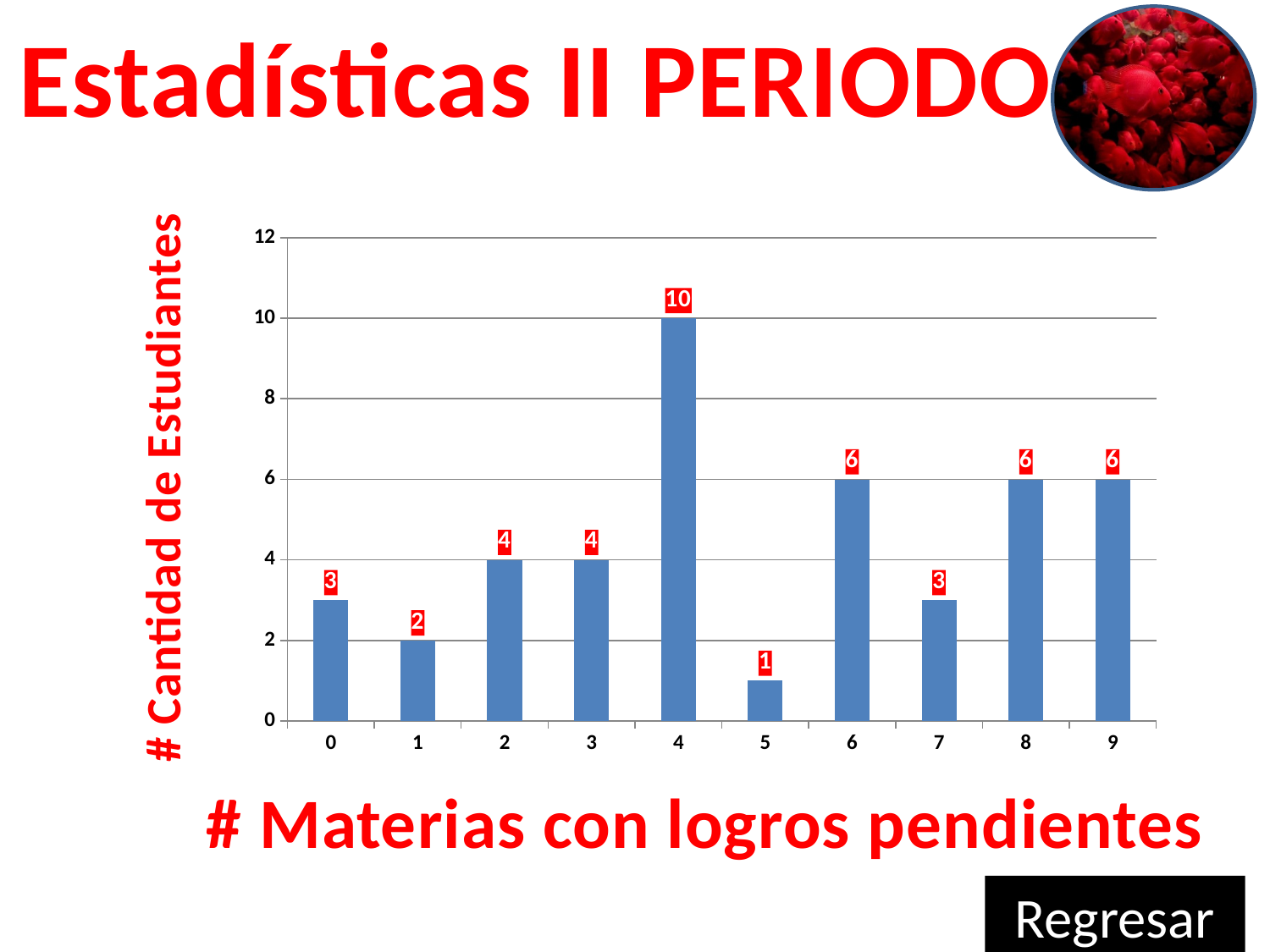
What is the label of the horizontal axis? # Materias con logros pendientes How many categories are shown on the x axis? 10 What is the label of the vertical axis? # Cantidad de Estudiantes What kind of chart is shown on the slide? bar chart Which category has the lowest number of students? 5 How many students have 4 subjects with pending achievements? 10 What is the value for category 0 on the x axis? 3 What is the difference between the values for category 4 and category 6? 4 What is the value for category 5 on the x axis? 1 Which category has the highest number of students? 4 Which is larger, the value for category 1 or the value for category 7? category 7 Is the value for category 4 greater or less than 8? greater